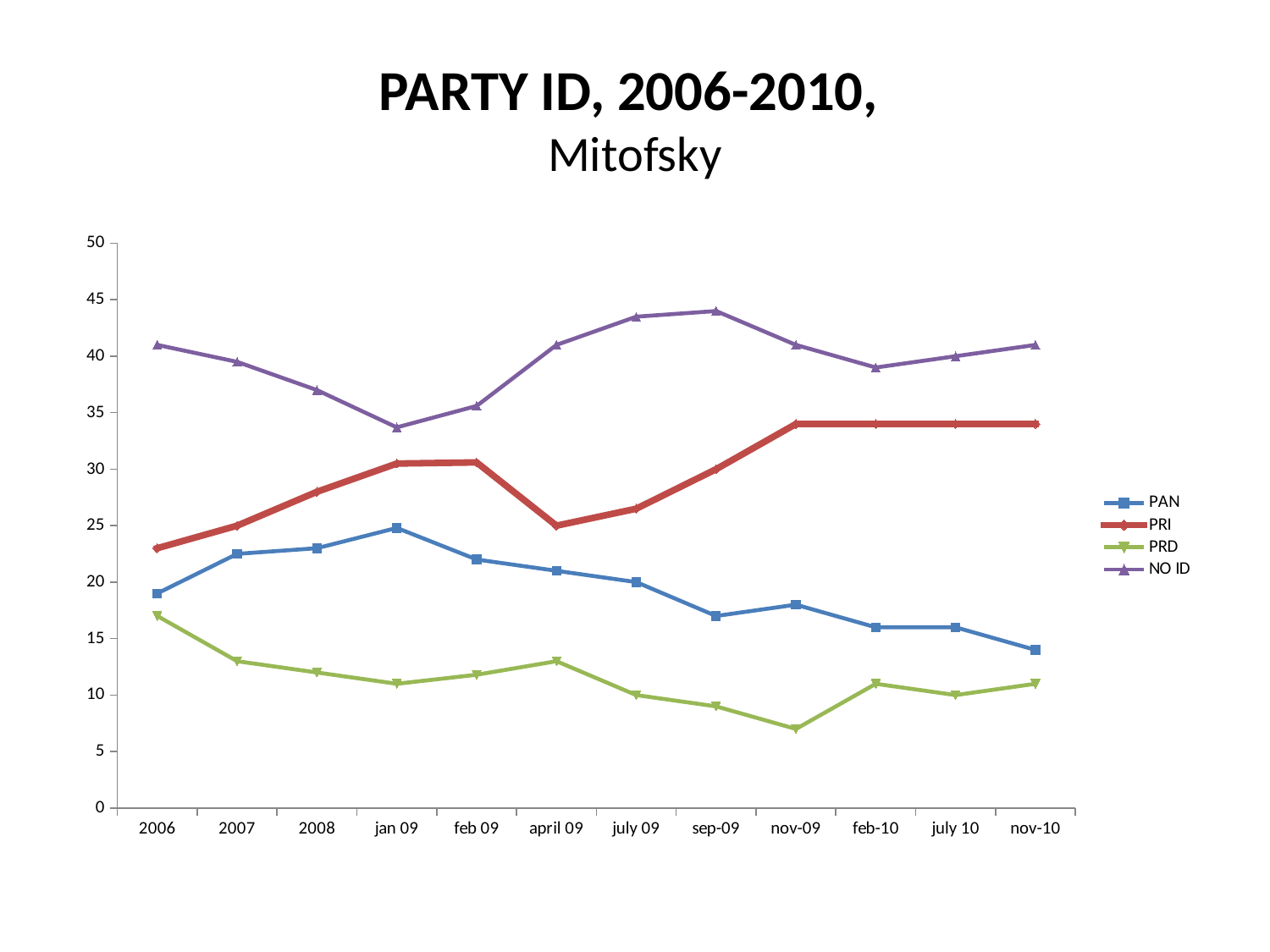
Which series has the highest value at nov-10? NO ID Does the PAN line rise or fall from jan 09 to nov-10? fall At which time point does the NO ID series reach its lowest value? jan 09 What kind of chart is shown on the slide? line chart Is the value for PRI at nov-10 greater or less than 30? greater What is the title of the chart? PARTY ID, 2006-2010, Mitofsky How many time points are shown along the x axis? 12 Which series has the lowest value at nov-09? PRD At 2006, which is larger, PRI or PAN? PRI Is the value for PRD at nov-09 greater or less than 10? less Is the value for NO ID at sep-09 greater or less than 40? greater How many series does the legend list? 4